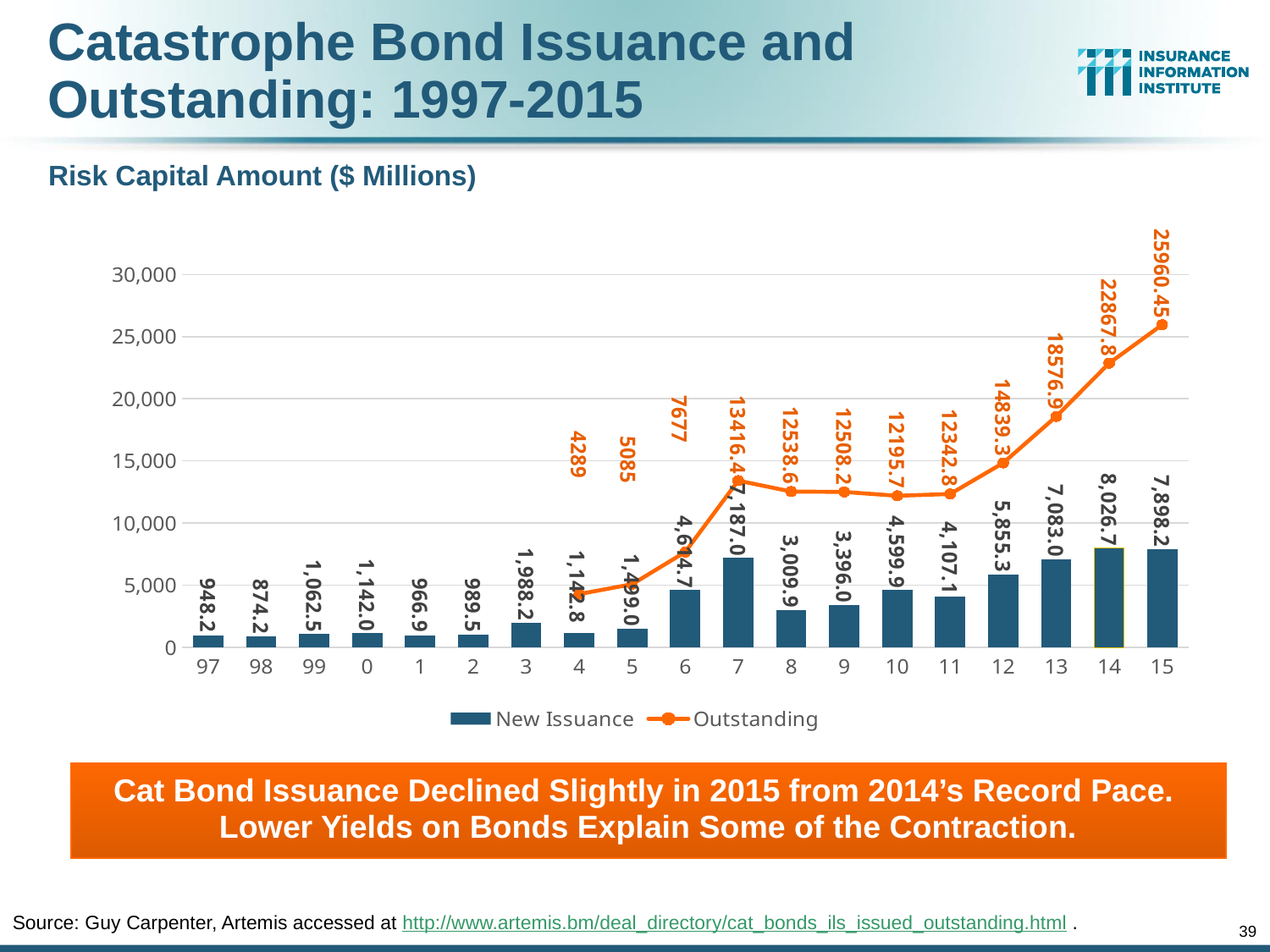
What is the unit of the values shown in the chart, according to the subtitle? $ Millions How many series does the legend list? 2 What is the difference between the New Issuance values for 2014 (14) and 2015 (15)? 128.5 What is the Outstanding value for 2015 (labelled 15)? 25960.45 Is the Outstanding value for 2013 (13) greater or less than 15,000? greater Which year has the highest New Issuance value? 14 Which is larger, the New Issuance value for 2008 (8) or for 2009 (9)? 2009 (9) Which year has the highest Outstanding value? 15 Which year has the lowest New Issuance value? 98 What is the New Issuance value for 2014 (labelled 14)? 8,026.7 How many years are shown on the x axis? 19 What is the New Issuance value for 2007 (labelled 7)? 7,187.0